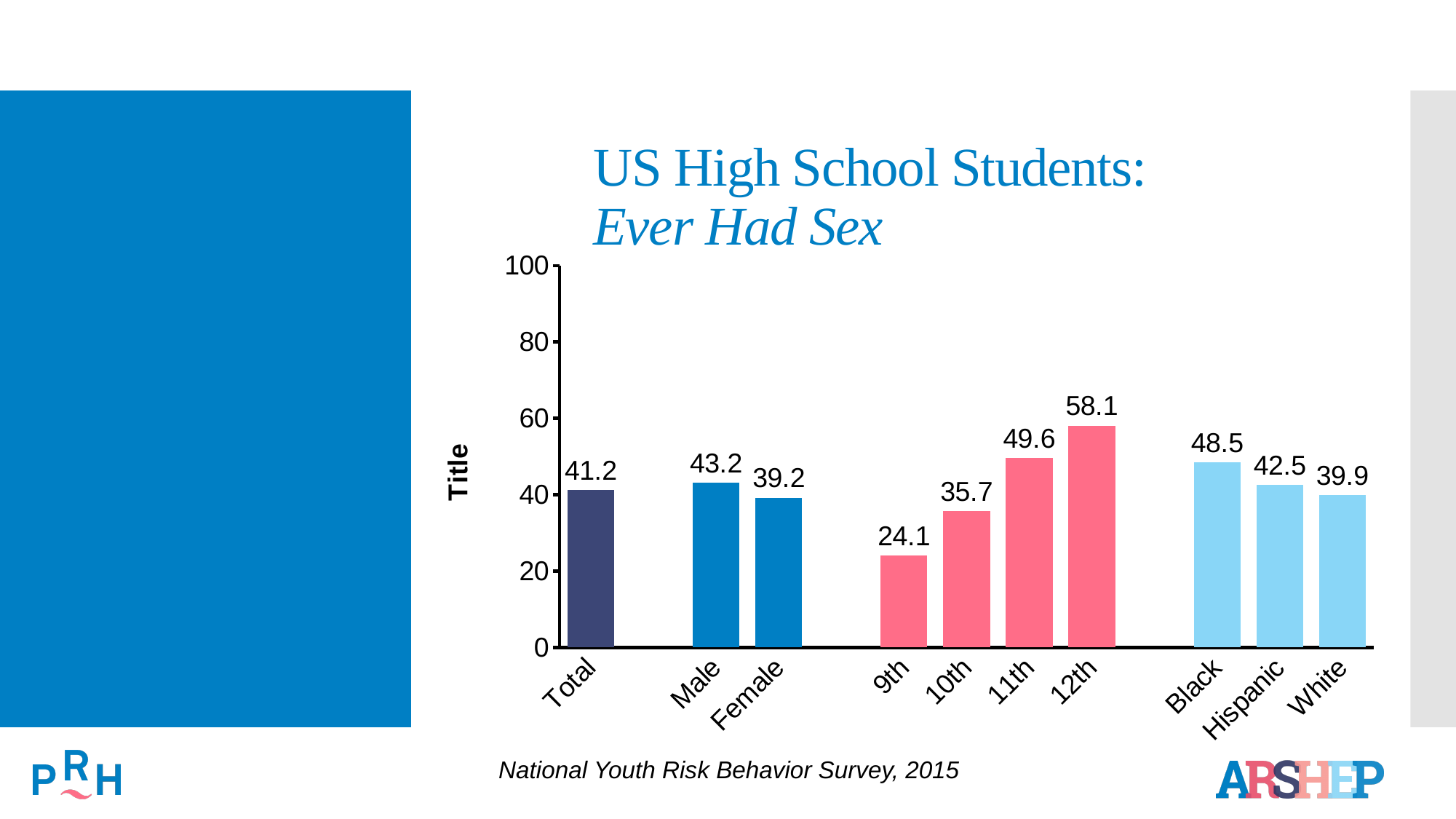
What is the value for 12th graders? 58.1 Which category has the highest value? 12th How many categories are shown on the x axis? 10 Which is larger, the value for Black or the value for White? Black What is the difference between the Male and Female values? 4.0 Is the value for 11th graders greater or less than 40? greater Do the values rise or fall from 9th to 12th grade? rise What is the value for Hispanic students? 42.5 What is the difference between the 12th and 9th grade values? 34.0 What kind of chart is this? bar chart What is the value for Total? 41.2 Which category has the lowest value? 9th